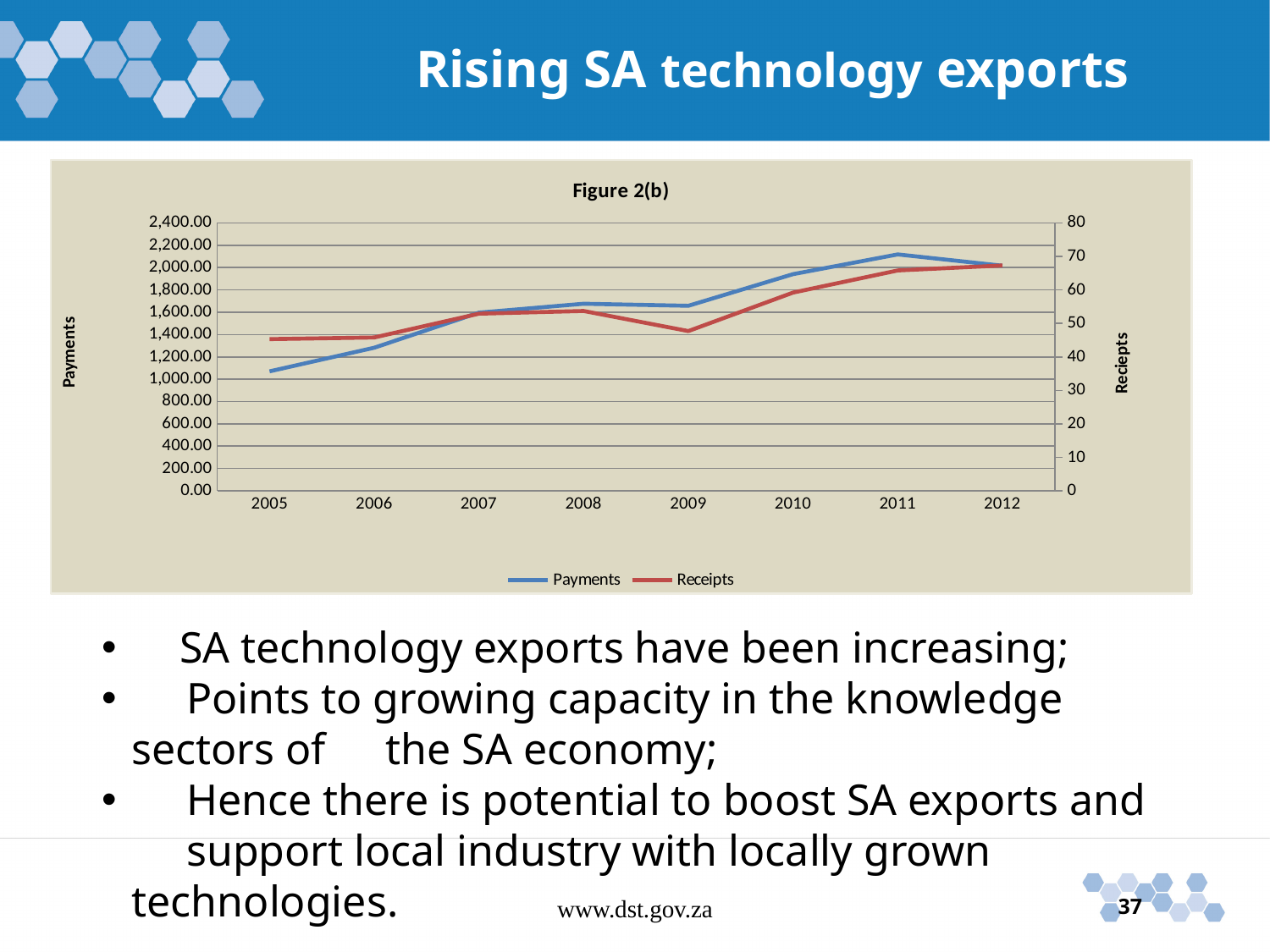
Do the Payments values generally rise or fall from 2005 to 2012? rise What is the label of the right-hand vertical axis? Reciepts What is the title of the chart? Figure 2(b) Is the Payments value for 2005 greater or less than 1,200.00? less How many series does the chart legend list? 2 In which year is the Payments series at its highest? 2011 Is the Payments value for 2011 greater or less than 2,000.00? greater Is the Receipts value for 2011 greater or less than 60? greater What kind of chart is shown on the slide? line chart Which year has the larger Receipts value, 2008 or 2009? 2008 How many years are plotted along the x axis of the chart? 8 In which year is the Payments series at its lowest? 2005